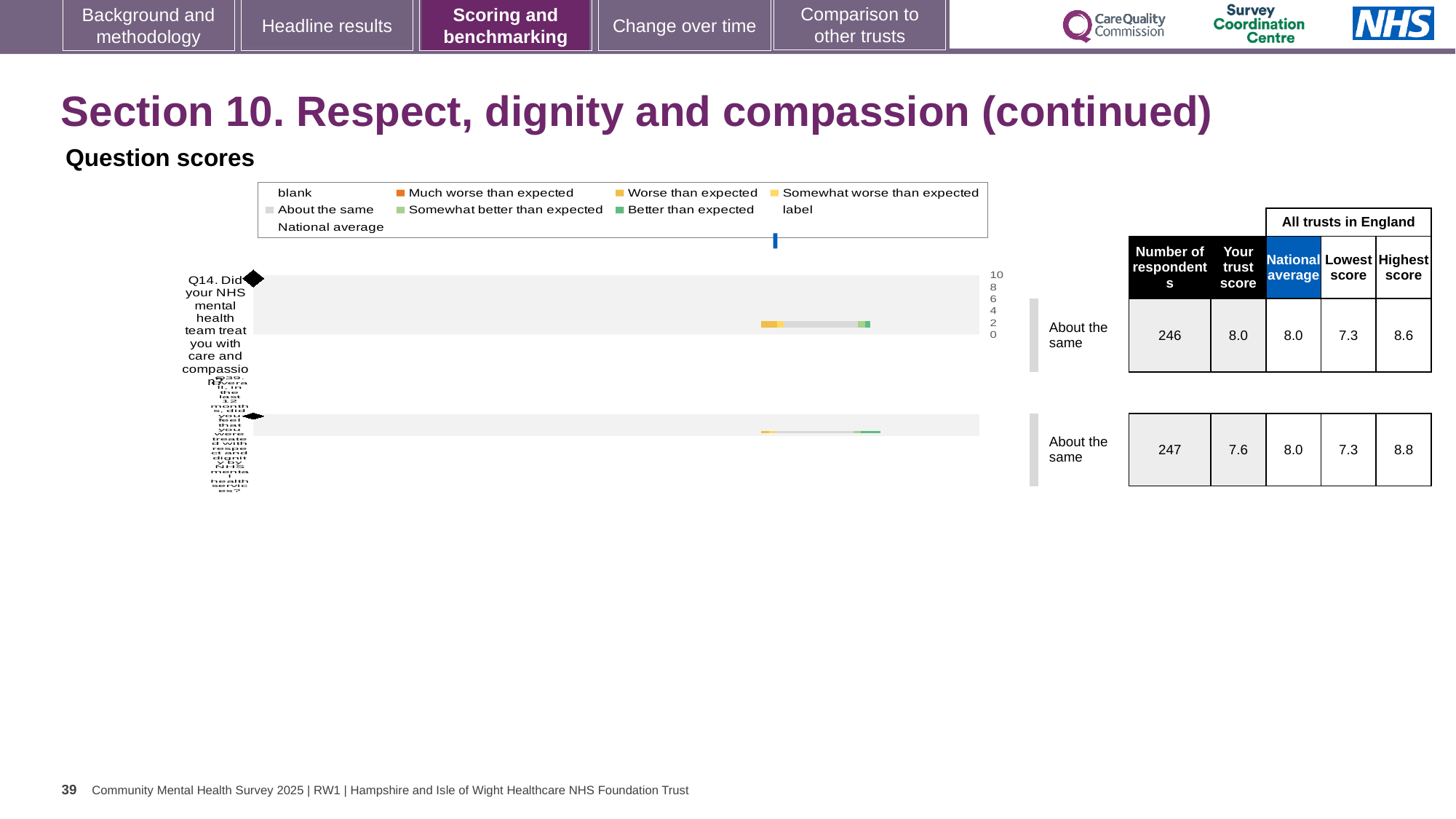
What benchmark category is shown for Q14 in the question scores chart? About the same What kind of chart is used to show the question scores on this slide? bar chart What is the difference between the highest and lowest scores for Q39? 1.5 What is the national average for Q39? 8.0 How many questions are plotted in the question scores chart? 2 By how much is the national average higher than the trust score for Q39? 0.4 What is the highest score across all trusts in England for Q39? 8.8 What is the trust score for Q14 (care and compassion)? 8.0 What is the number of respondents for Q14 in the question scores table? 246 What is the trust score for Q39 (respect and dignity)? 7.6 Which question has the higher trust score, Q14 or Q39? Q14 What is the lowest score across all trusts in England for Q14? 7.3